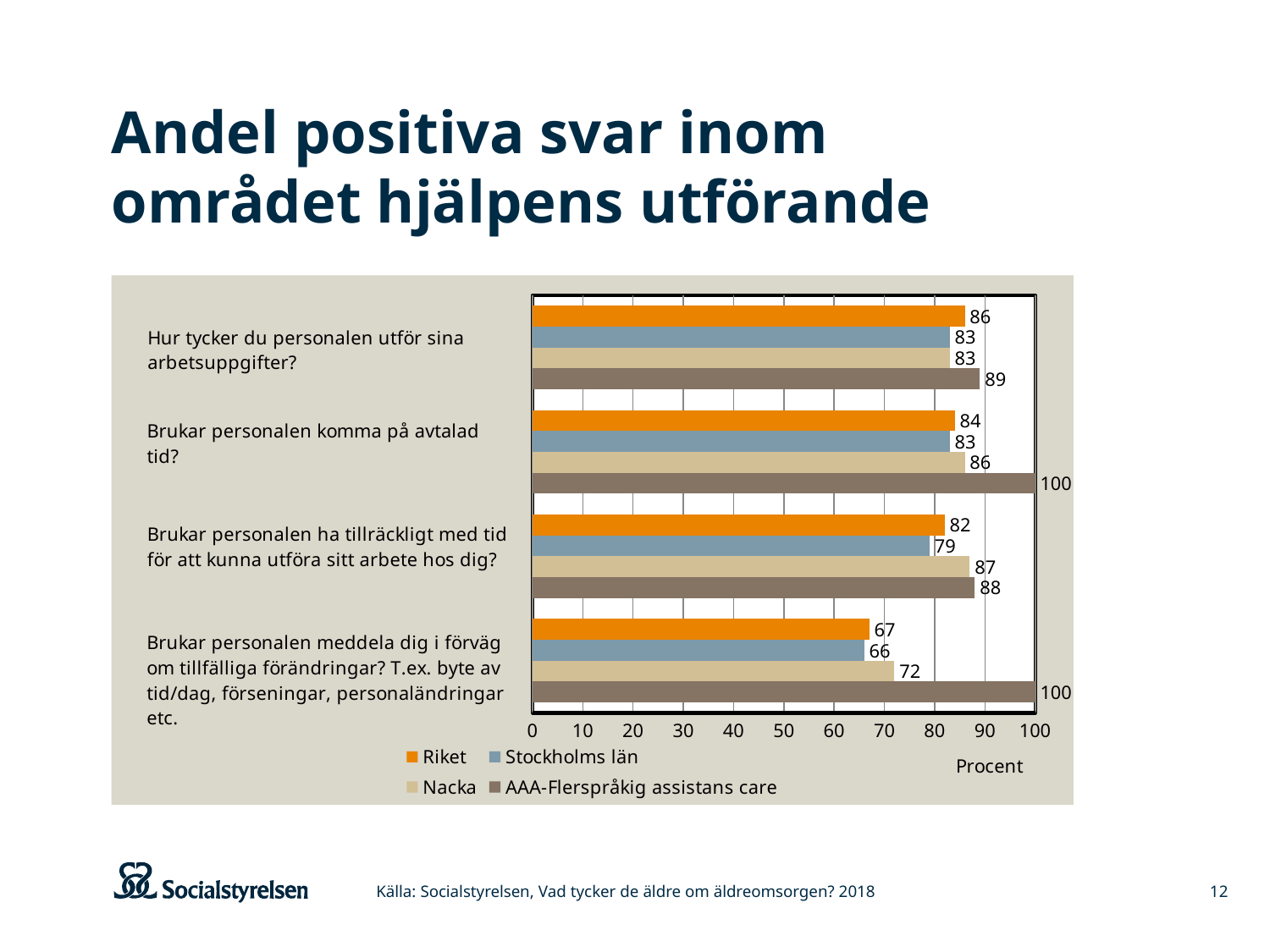
What is the value for Nacka on the question "Brukar personalen meddela dig i förväg om tillfälliga förändringar?"? 72 How many questions (categories) are shown on the chart? 4 What is the difference between AAA-Flerspråkig assistans care and Riket on the question "Brukar personalen meddela dig i förväg om tillfälliga förändringar?"? 33 What kind of chart is shown on the slide? Bar chart Which series has the lowest value on the question "Brukar personalen meddela dig i förväg om tillfälliga förändringar?"? Stockholms län What is the value for Stockholms län on the question "Brukar personalen ha tillräckligt med tid för att kunna utföra sitt arbete hos dig?"? 79 What is the value for AAA-Flerspråkig assistans care on the question "Brukar personalen komma på avtalad tid?"? 100 Which series has the highest value on the question "Hur tycker du personalen utför sina arbetsuppgifter?"? AAA-Flerspråkig assistans care Which is larger on the question "Brukar personalen ha tillräckligt med tid för att kunna utföra sitt arbete hos dig?": Riket or Nacka? Nacka What is the label of the horizontal axis? Procent How many series does the legend list? 4 What is the value for Riket on the question "Hur tycker du personalen utför sina arbetsuppgifter?"? 86